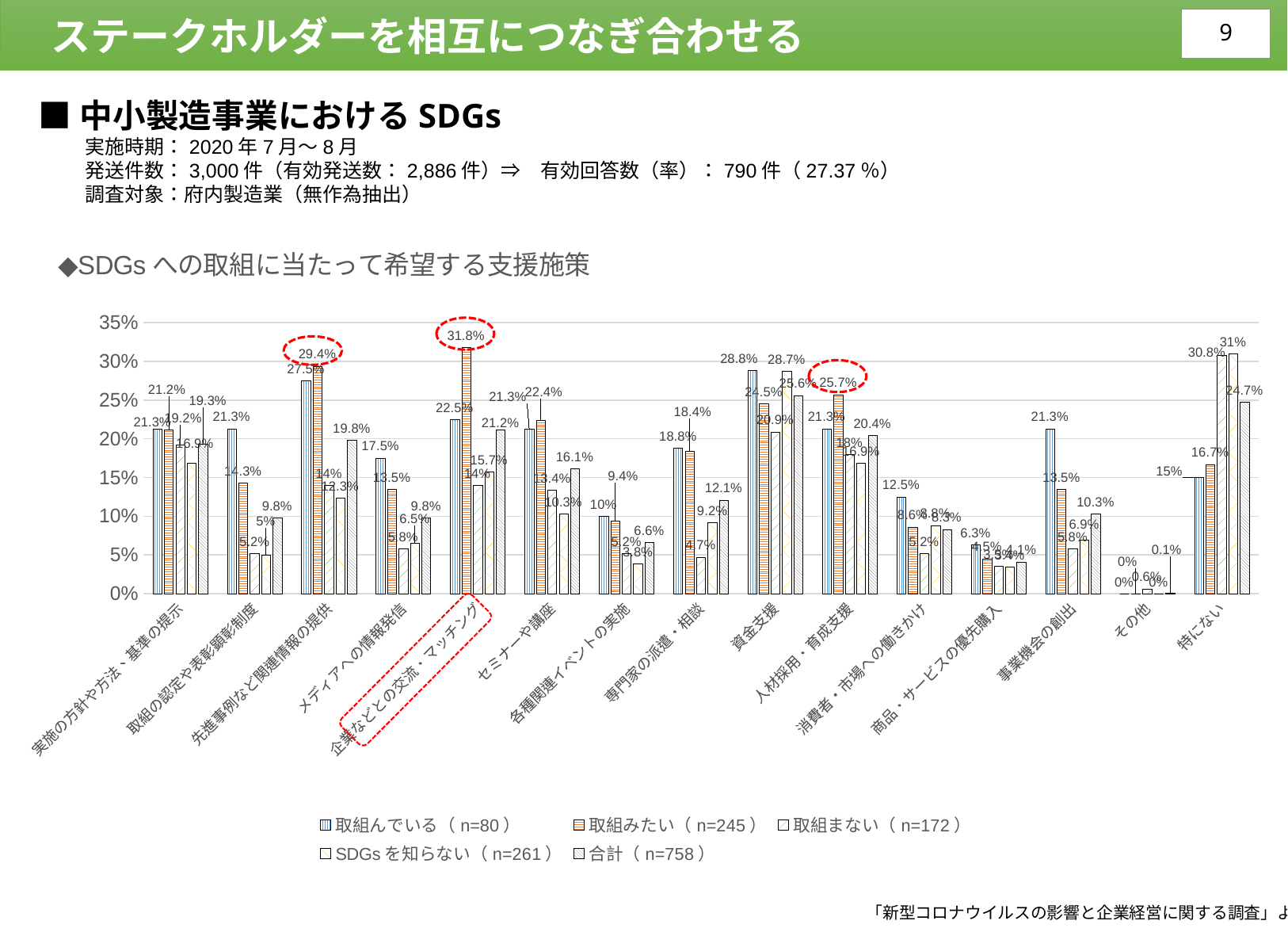
How many categories are shown along the x axis of the chart? 15 What is the value of 取組みたい for 企業などとの交流・マッチング? 31.8% What kind of chart is shown on the slide? bar chart What is the value of 取組みたい for 先進事例など関連情報の提供? 29.4% What is the value of 合計 for 特にない? 24.7% For 企業などとの交流・マッチング, what is the difference between the 取組みたい value and the 取組んでいる value? 9.3 percentage points For the 取組みたい series, which category has the highest value? 企業などとの交流・マッチング For the 合計 series, which category has the lowest value? その他 For 資金支援, which is larger: the 取組んでいる value or the 取組みたい value? 取組んでいる How many series does the legend list? 5 What is the value of 合計 for 資金支援? 25.6% What sample size (n) does the legend give for 合計? n=758